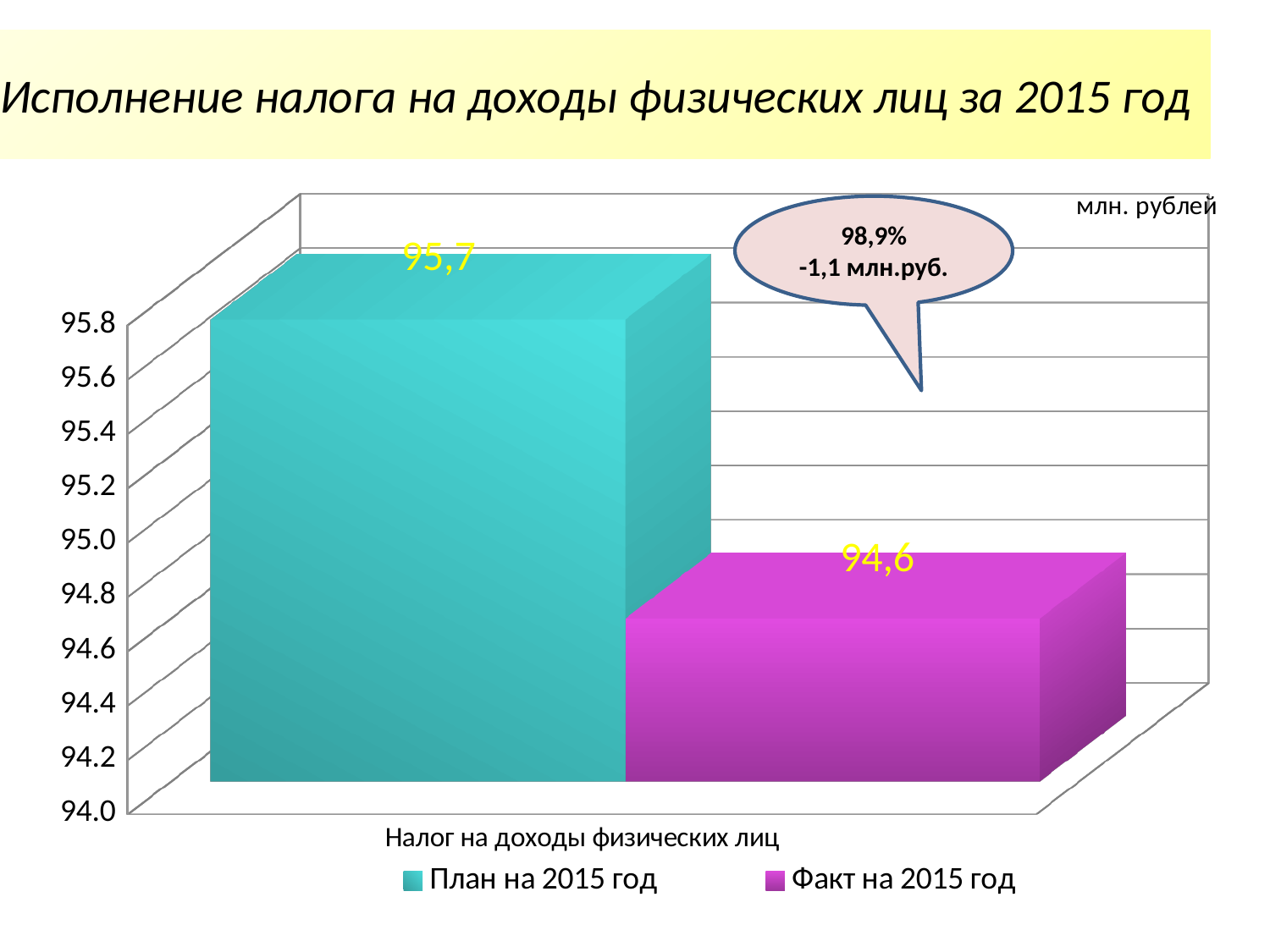
What kind of chart is shown on the slide? Bar chart Is the value for Факт на 2015 год greater or less than 95.0? less Is the value for План на 2015 год greater or less than 95.0? greater What is the value for План на 2015 год? 95,7 What is the value for Факт на 2015 год? 94,6 What is the category label on the x axis? Налог на доходы физических лиц What is the difference between the План на 2015 год value and the Факт на 2015 год value? 1,1 What unit is indicated in the top right corner of the chart? млн. рублей How many categories are shown on the x axis? 1 Which series has the higher value, План на 2015 год or Факт на 2015 год? План на 2015 год What percentage is shown in the callout on the chart? 98,9% How many series does the legend list? 2